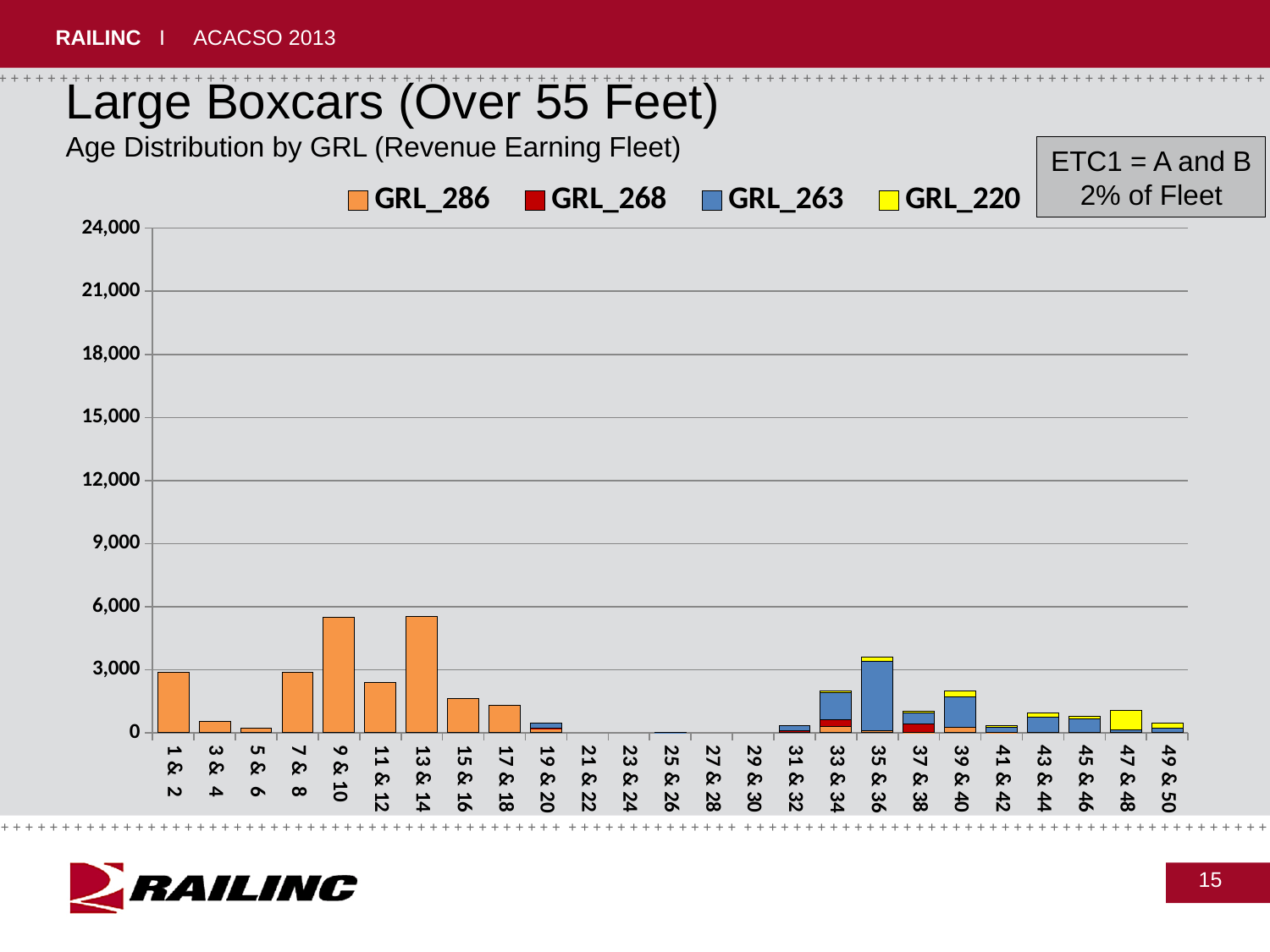
Is the total value for the 15 & 16 category greater or less than 3,000? less How many age categories are shown along the x axis? 25 Which category has the larger total, 35 & 36 or 33 & 34? 35 & 36 Which category has the larger total, 9 & 10 or 11 & 12? 9 & 10 How many series does the legend list? 4 Which category has the larger total, 1 & 2 or 3 & 4? 1 & 2 Which series is shown in orange in the legend? GRL_286 Is the total value for the 35 & 36 category greater or less than 3,000? greater Is the total value for the 9 & 10 category greater or less than 3,000? greater What is the subtitle of the chart below 'Large Boxcars (Over 55 Feet)'? Age Distribution by GRL (Revenue Earning Fleet) What kind of chart is shown on the slide? Stacked bar chart